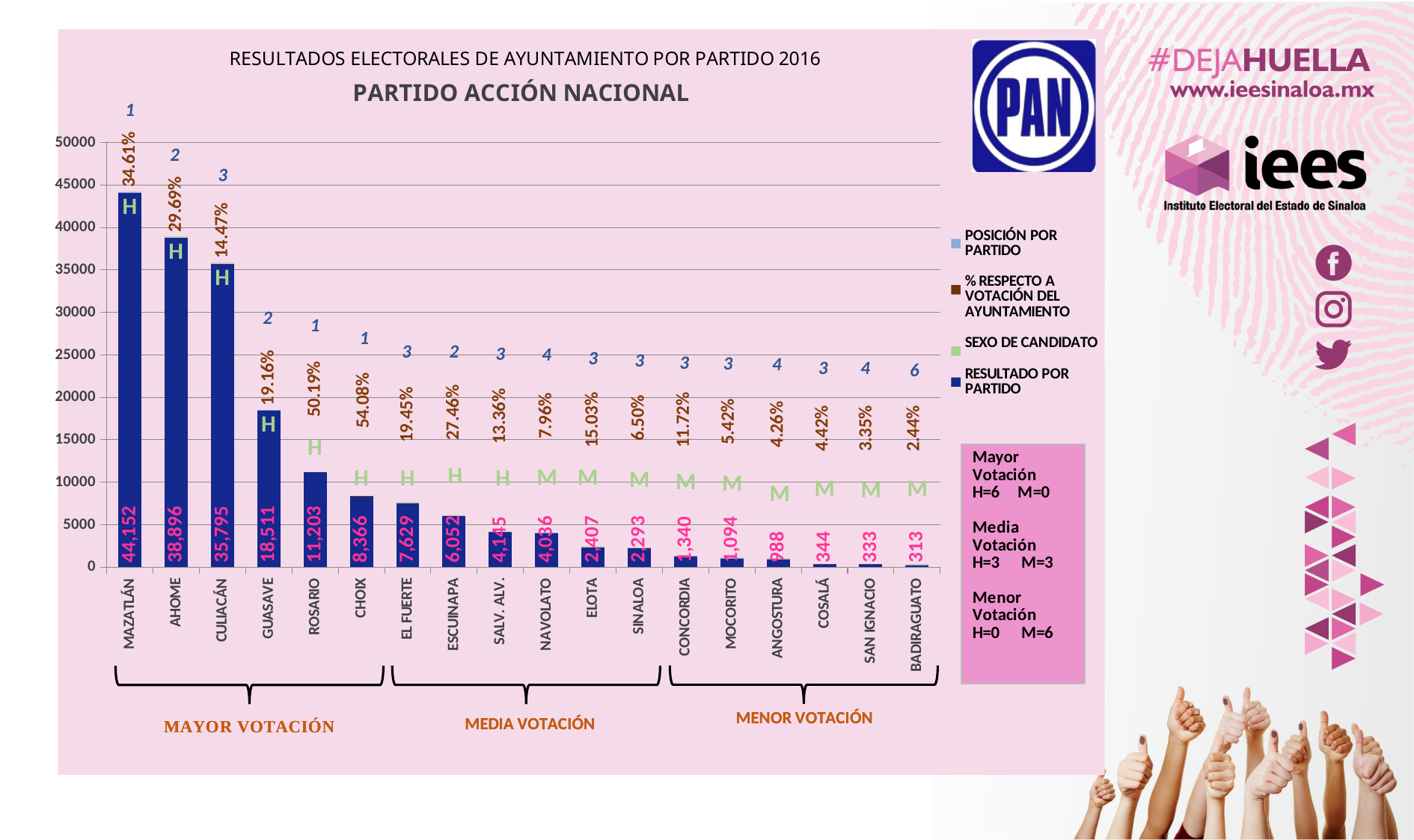
How many series does the chart legend list? 4 Which has a larger RESULTADO POR PARTIDO, ROSARIO or CHOIX? ROSARIO What is the RESULTADO POR PARTIDO value for MAZATLÁN? 44,152 What is the RESULTADO POR PARTIDO value for BADIRAGUATO? 313 What is the difference between the RESULTADO POR PARTIDO values for MAZATLÁN and AHOME? 5,256 Do the RESULTADO POR PARTIDO values rise or fall from left to right along the x axis? fall What percentage (% RESPECTO A VOTACIÓN DEL AYUNTAMIENTO) is shown for CHOIX? 54.08% Which municipality has the highest RESULTADO POR PARTIDO? MAZATLÁN Which municipality has the lowest RESULTADO POR PARTIDO? BADIRAGUATO What kind of chart is shown on the slide? bar chart What is the RESULTADO POR PARTIDO value for GUASAVE? 18,511 How many municipalities are shown on the x axis of the chart? 18